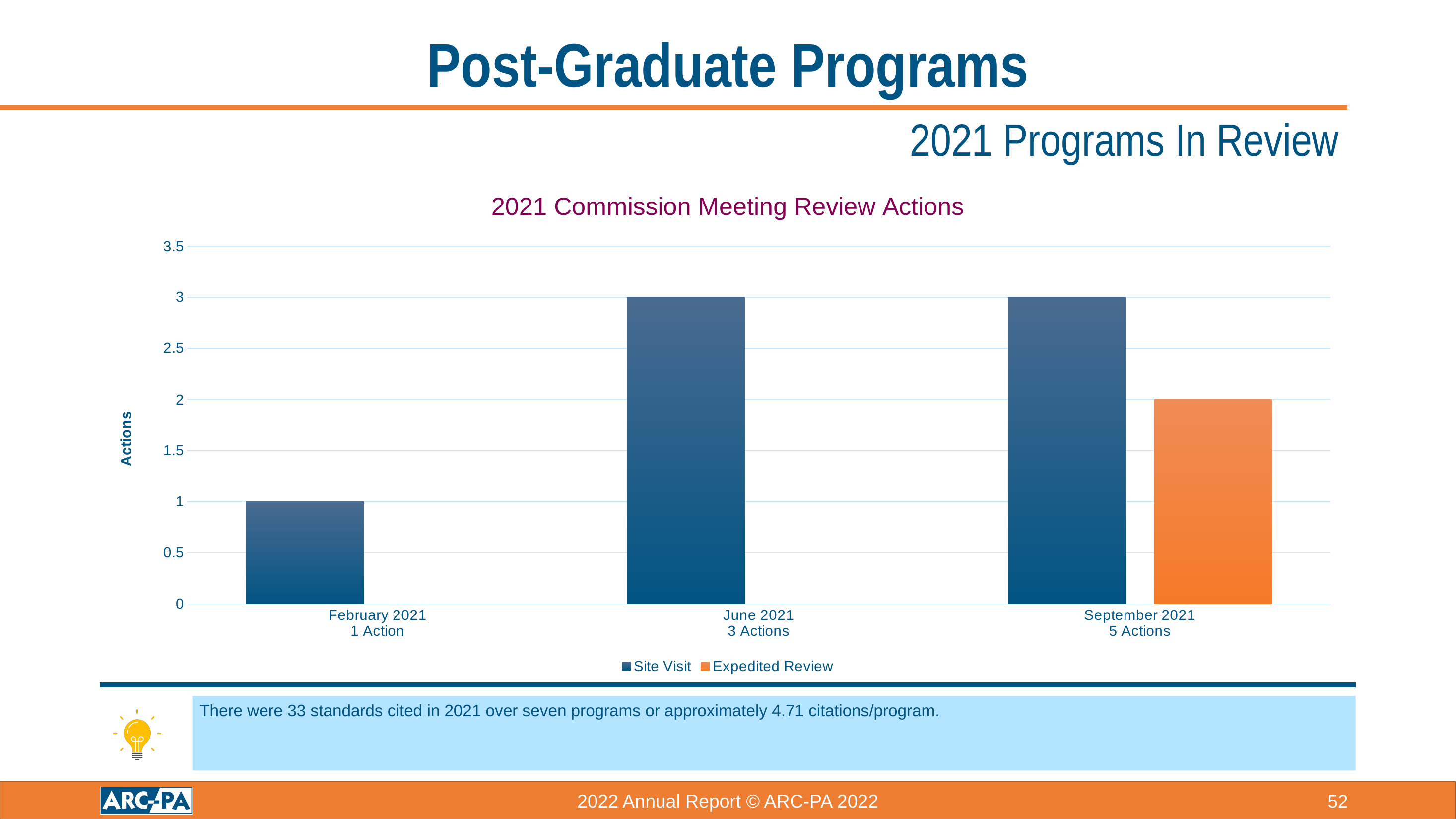
What is the Site Visit value for February 2021? 1 What is the Site Visit value for June 2021? 3 What is the Expedited Review value for September 2021? 2 For September 2021, which is larger, Site Visit or Expedited Review? Site Visit Which meeting has the lowest Site Visit value? February 2021 How many total actions are listed for September 2021 in its axis label? 5 Actions How many series does the legend list? 2 What is the title of the chart? 2021 Commission Meeting Review Actions What is the difference between the Site Visit value for June 2021 and the Site Visit value for February 2021? 2 How many meeting categories are shown on the x axis? 3 Do the Site Visit values rise or fall from February 2021 to June 2021? Rise What kind of chart is shown on the slide? Bar chart